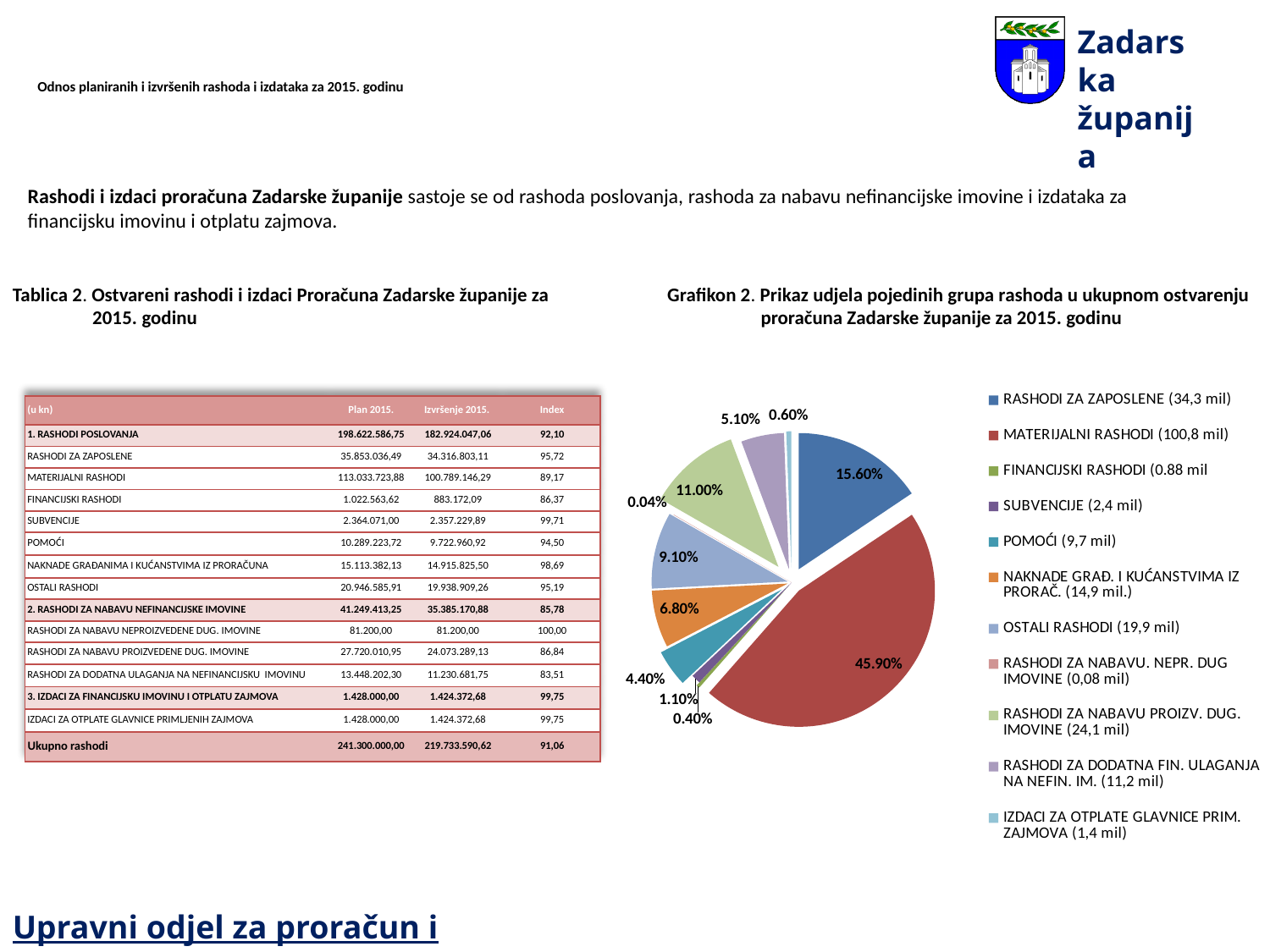
In Grafikon 2, what is the difference in percentage points between the MATERIJALNI RASHODI slice (45.90%) and the RASHODI ZA ZAPOSLENE slice (15.60%)? 30.30 What is the title of the pie chart on the slide? Grafikon 2. Prikaz udjela pojedinih grupa rashoda u ukupnom ostvarenju proračuna Zadarske županije za 2015. godinu In Grafikon 2, what share of the pie is labelled for OSTALI RASHODI? 9.10% What kind of chart is Grafikon 2? pie chart In Grafikon 2, which category has the smallest share of the pie? RASHODI ZA NABAVU. NEPR. DUG IMOVINE (0,08 mil) How many entries does the legend of Grafikon 2 list? 11 In Grafikon 2, what share of the pie is labelled for RASHODI ZA NABAVU PROIZV. DUG. IMOVINE? 11.00% In Grafikon 2, which slice is larger: POMOĆI or NAKNADE GRAĐ. I KUĆANSTVIMA IZ PRORAČ.? NAKNADE GRAĐ. I KUĆANSTVIMA IZ PRORAČ. In Grafikon 2, what share of the pie is labelled for IZDACI ZA OTPLATE GLAVNICE PRIM. ZAJMOVA? 0.60% In Grafikon 2, which category has the largest share of the pie? MATERIJALNI RASHODI (100,8 mil) In Grafikon 2, what share of the pie is labelled for RASHODI ZA ZAPOSLENE? 15.60% In Grafikon 2, what share of the pie is labelled for MATERIJALNI RASHODI? 45.90%